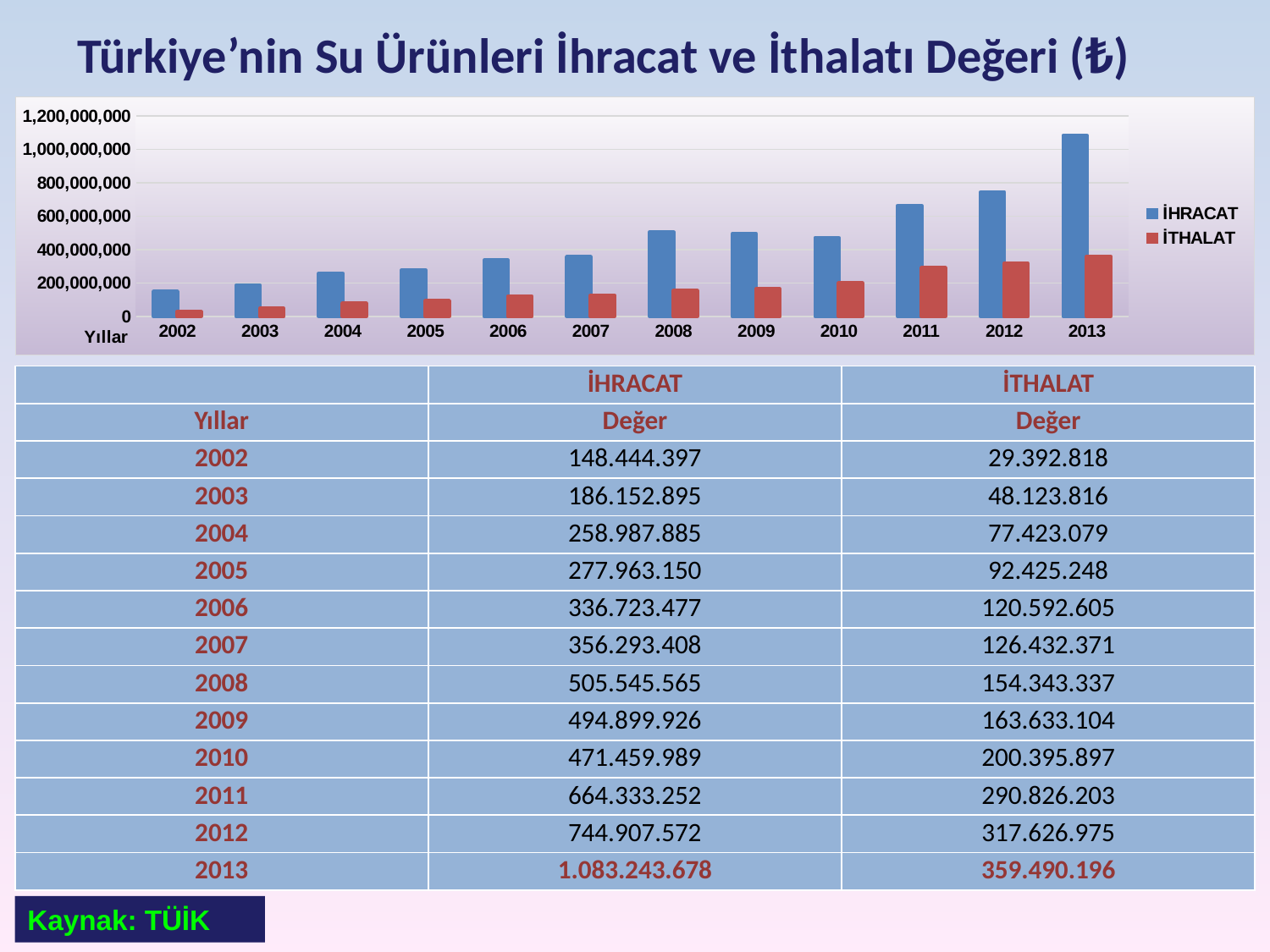
Which is larger in 2011, İHRACAT or İTHALAT? İHRACAT Which colour represents İTHALAT in the chart? red What is the İTHALAT value for 2010? 200.395.897 How many years are shown on the x axis of the chart? 12 Which year has the highest İHRACAT value? 2013 What is the İHRACAT value for 2013? 1.083.243.678 What kind of chart is shown on the slide? bar chart Which year has the lowest İTHALAT value? 2002 Do the İTHALAT values generally rise or fall from 2002 to 2013? rise Is the İHRACAT value for 2013 greater or less than 1,000,000,000? greater How many series does the chart legend list? 2 Is the İTHALAT value for 2012 greater or less than 400,000,000? less